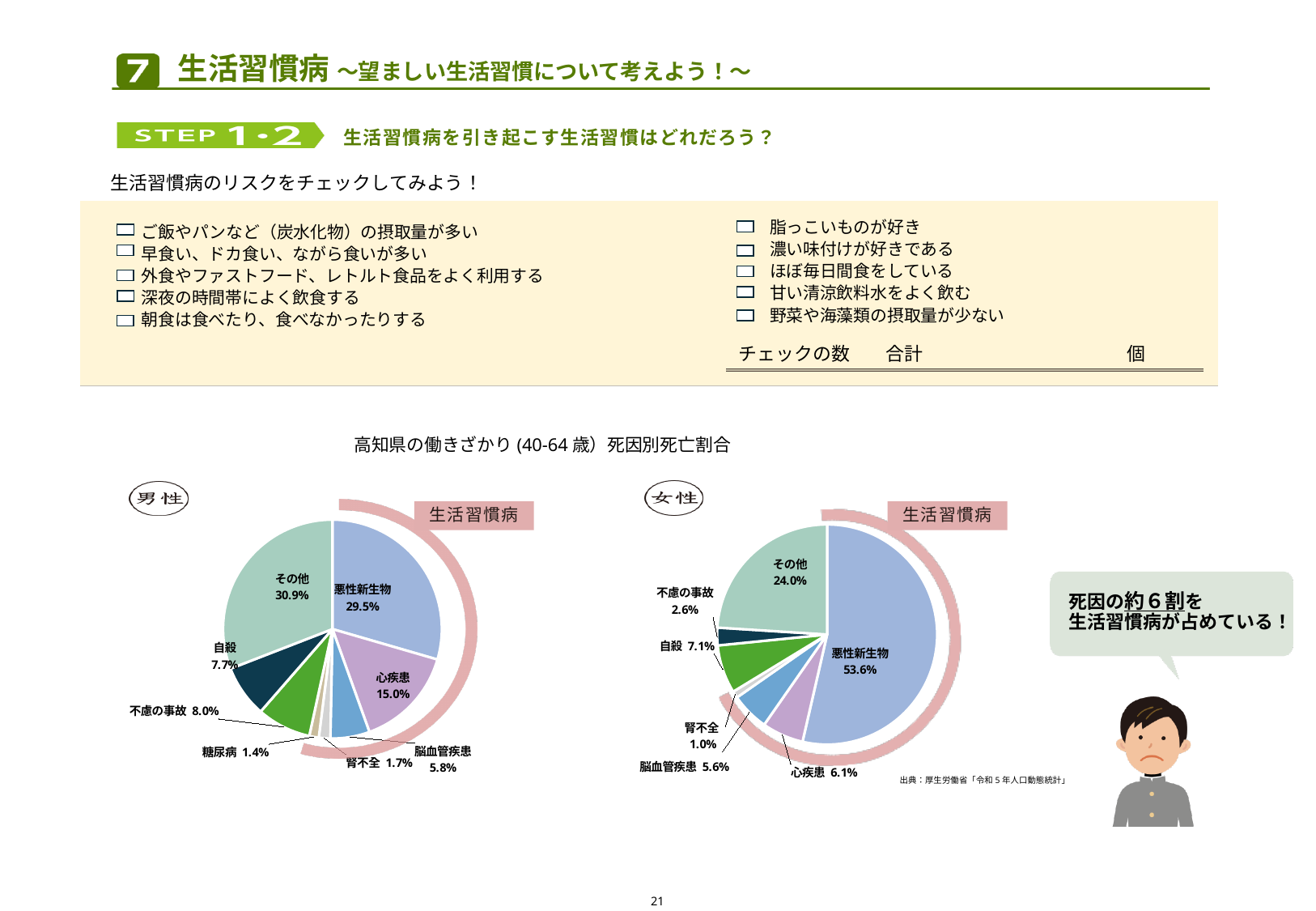
In the 女性 pie chart, what is the share for 悪性新生物? 53.6% In the 男性 pie chart, what is the share for 悪性新生物? 29.5% What type of chart is used to show the 死因別死亡割合 for 男性 and 女性? Pie chart In the 男性 pie chart, which cause of death has the largest share? その他 How many categories are shown in the 女性 pie chart? 7 In the 女性 pie chart, which cause of death has the smallest share? 腎不全 In the 女性 pie chart, what is the share for その他? 24.0% In the 男性 pie chart, which cause of death has the smallest share? 糖尿病 In the 男性 pie chart, which is larger, the share for 不慮の事故 or the share for 自殺? 不慮の事故 In the 男性 pie chart, what is the share for 心疾患? 15.0% How many categories are shown in the 男性 pie chart? 8 In the 女性 pie chart, what is the difference between the shares for 悪性新生物 and その他? 29.6%